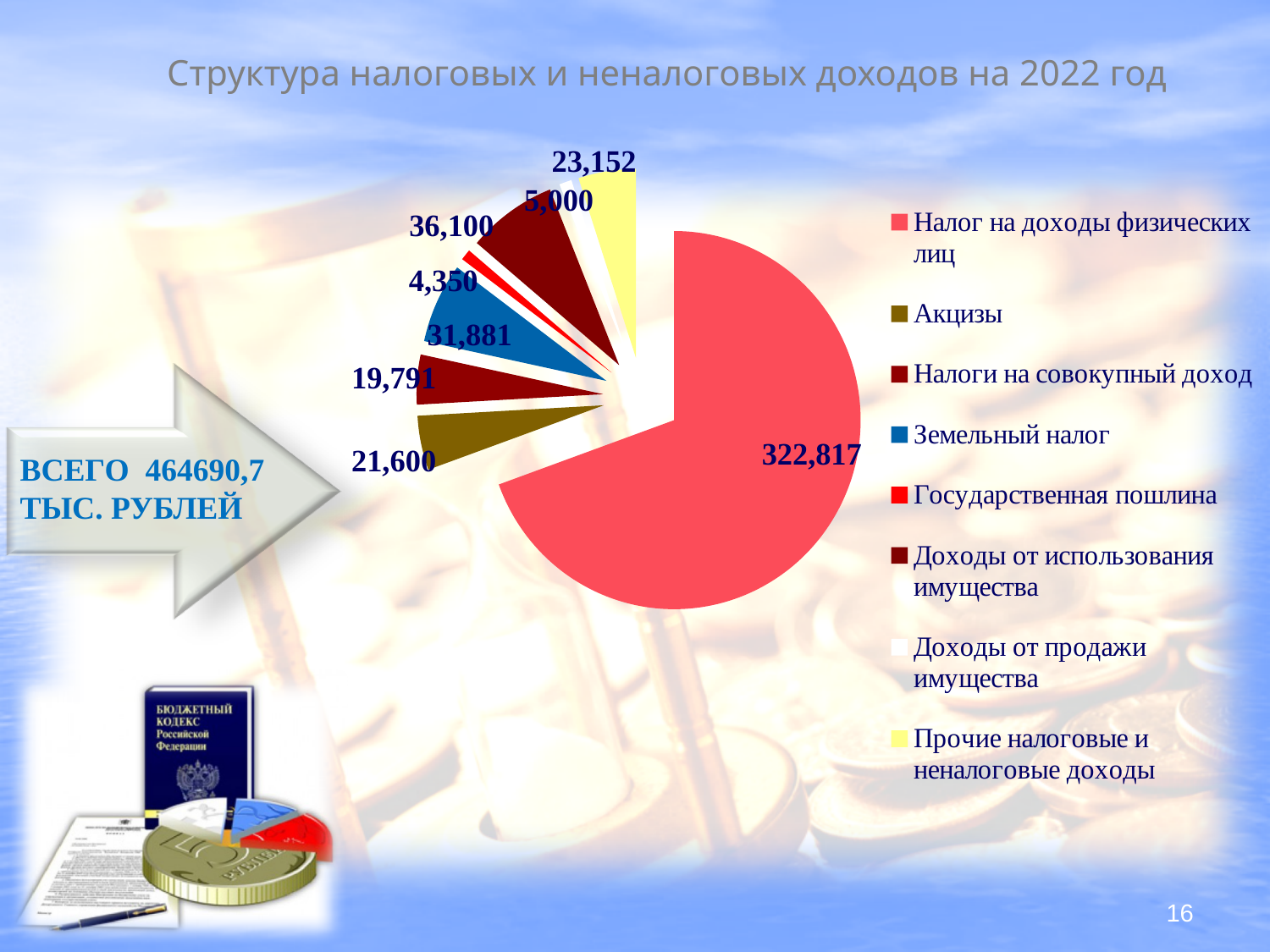
What is the value for Прочие налоговые и неналоговые доходы? 23,152 How many slices does the pie chart have? 8 Which category has the largest slice of the pie? Налог на доходы физических лиц Which category has the smallest slice of the pie? Государственная пошлина What is the value for Доходы от использования имущества? 36,100 Which is larger, the value for Акцизы or the value for Налоги на совокупный доход? Акцизы What type of chart is shown on the slide? Pie chart What is the value for Налог на доходы физических лиц? 322,817 What is the value for Акцизы? 21,600 What is the title of the slide containing the chart? Структура налоговых и неналоговых доходов на 2022 год What is the value for Земельный налог? 31,881 What is the difference between the values for Доходы от использования имущества and Земельный налог? 4,219